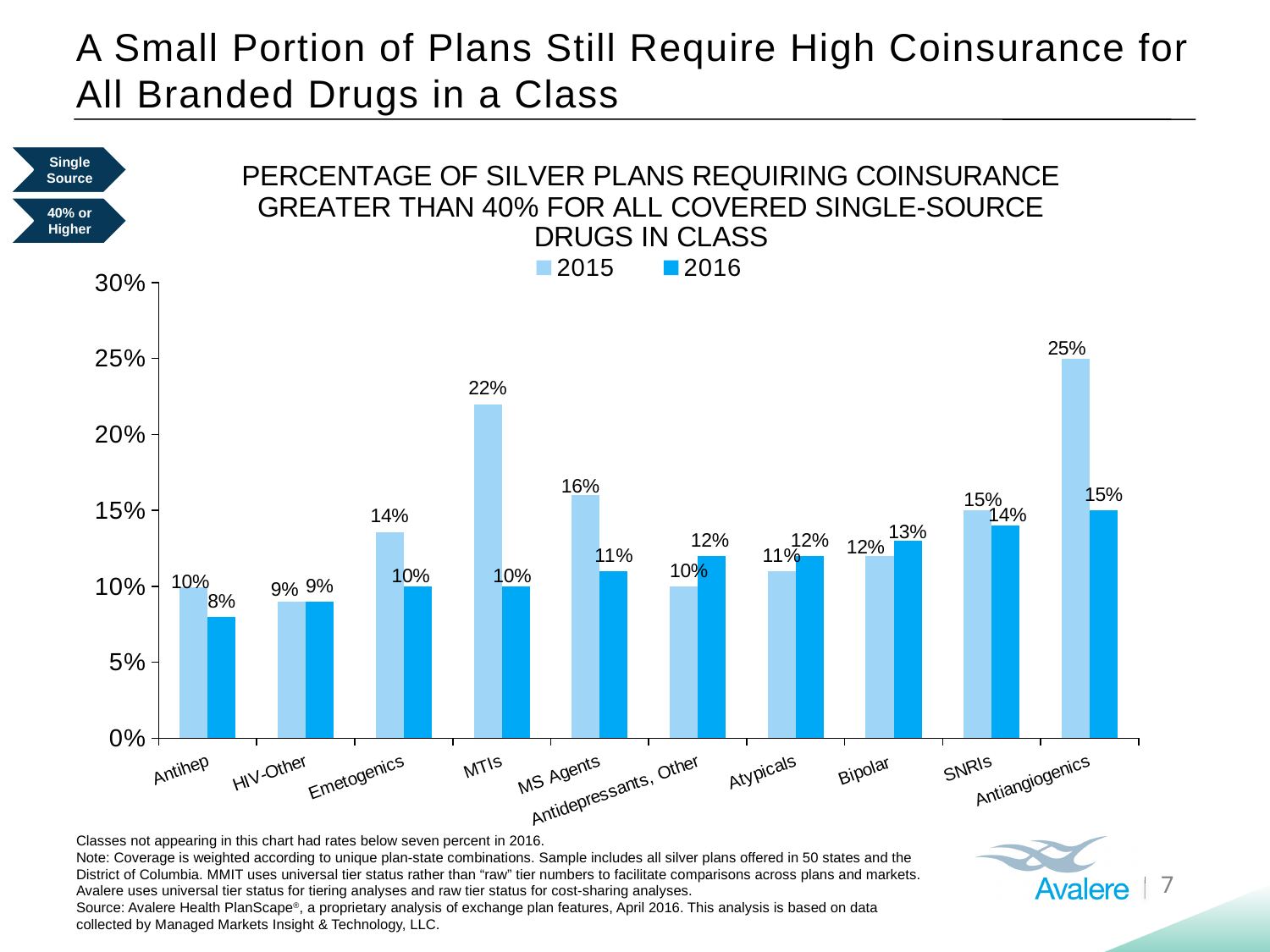
What is the difference between the 2015 and 2016 values for Antiangiogenics? 10% What kind of chart is shown on the slide? Bar chart What is the 2015 value for MTIs? 22% What is the difference between the 2015 and 2016 values for MTIs? 12% How many drug classes are shown on the x axis? 10 Is the 2015 value for Antiangiogenics greater or less than 20%? greater Which drug class has the highest 2015 value? Antiangiogenics For Bipolar, which year has the larger value, 2015 or 2016? 2016 Which drug class has the lowest 2016 value? Antihep What is the 2016 value for Antihep? 8% How many series does the legend list? 2 What is the 2016 value for Antiangiogenics? 15%